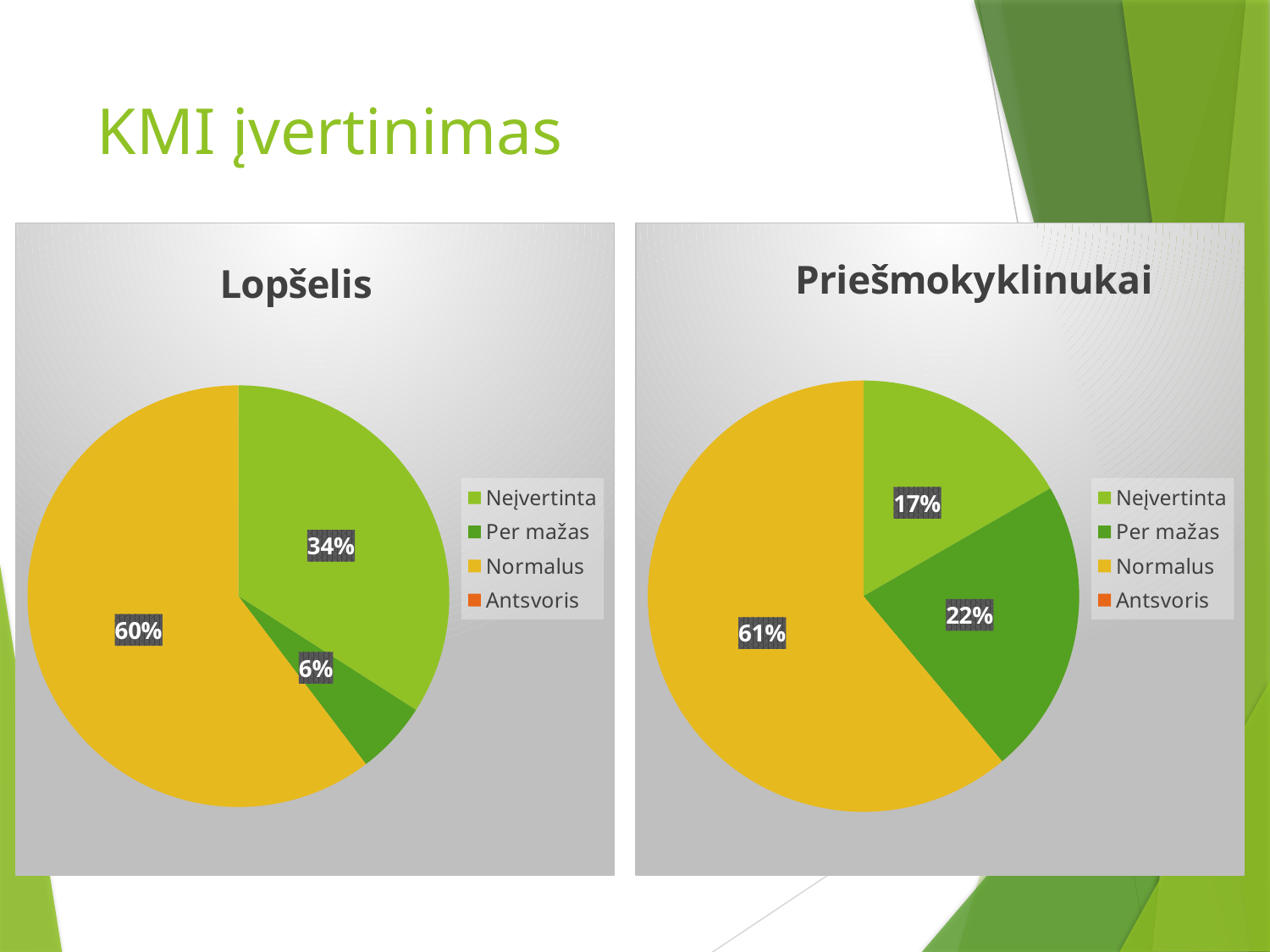
In the Lopšelis chart, what share does Per mažas have? 6% In the Priešmokyklinukai chart, what share does Per mažas have? 22% In the Priešmokyklinukai chart, which is larger, Per mažas or Neįvertinta? Per mažas In the Lopšelis chart, what is the difference between the Normalus and Neįvertinta shares? 26% What kind of chart is the Lopšelis chart? Pie chart In the Priešmokyklinukai chart, which labelled slice is the smallest? Neįvertinta In the Lopšelis chart, which category has the largest slice? Normalus In the Priešmokyklinukai chart, what share does Normalus have? 61% How many entries does the legend of the Priešmokyklinukai chart list? 4 In the Lopšelis chart, what share does Neįvertinta have? 34% In the Lopšelis chart, what share does Normalus have? 60% In the Priešmokyklinukai chart, what share does Neįvertinta have? 17%